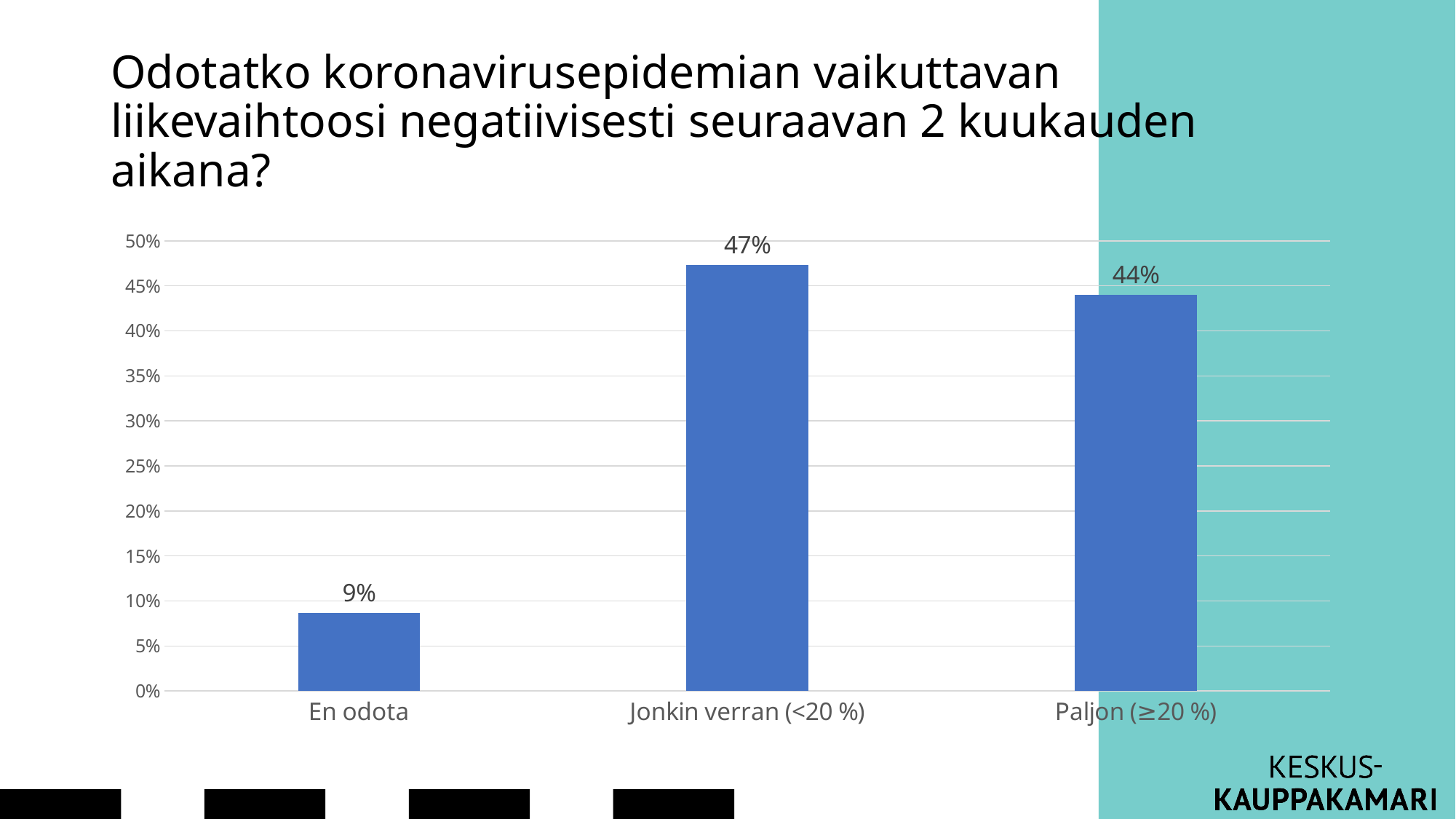
What is the value for "Paljon (≥20 %)"? 44% What kind of chart is shown on the slide? bar chart What is the difference between the values for "Paljon (≥20 %)" and "En odota"? 35% Which category has the lowest value? En odota What is the highest value shown on the y axis? 50% How many categories are shown on the x axis? 3 What is the difference between the values for "Jonkin verran (<20 %)" and "Paljon (≥20 %)"? 3% What is the value for "En odota"? 9% Is the value for "Jonkin verran (<20 %)" greater or less than 45%? greater Which category has the highest value? Jonkin verran (<20 %) Which is larger, the value for "En odota" or the value for "Paljon (≥20 %)"? Paljon (≥20 %) What is the value for "Jonkin verran (<20 %)"? 47%